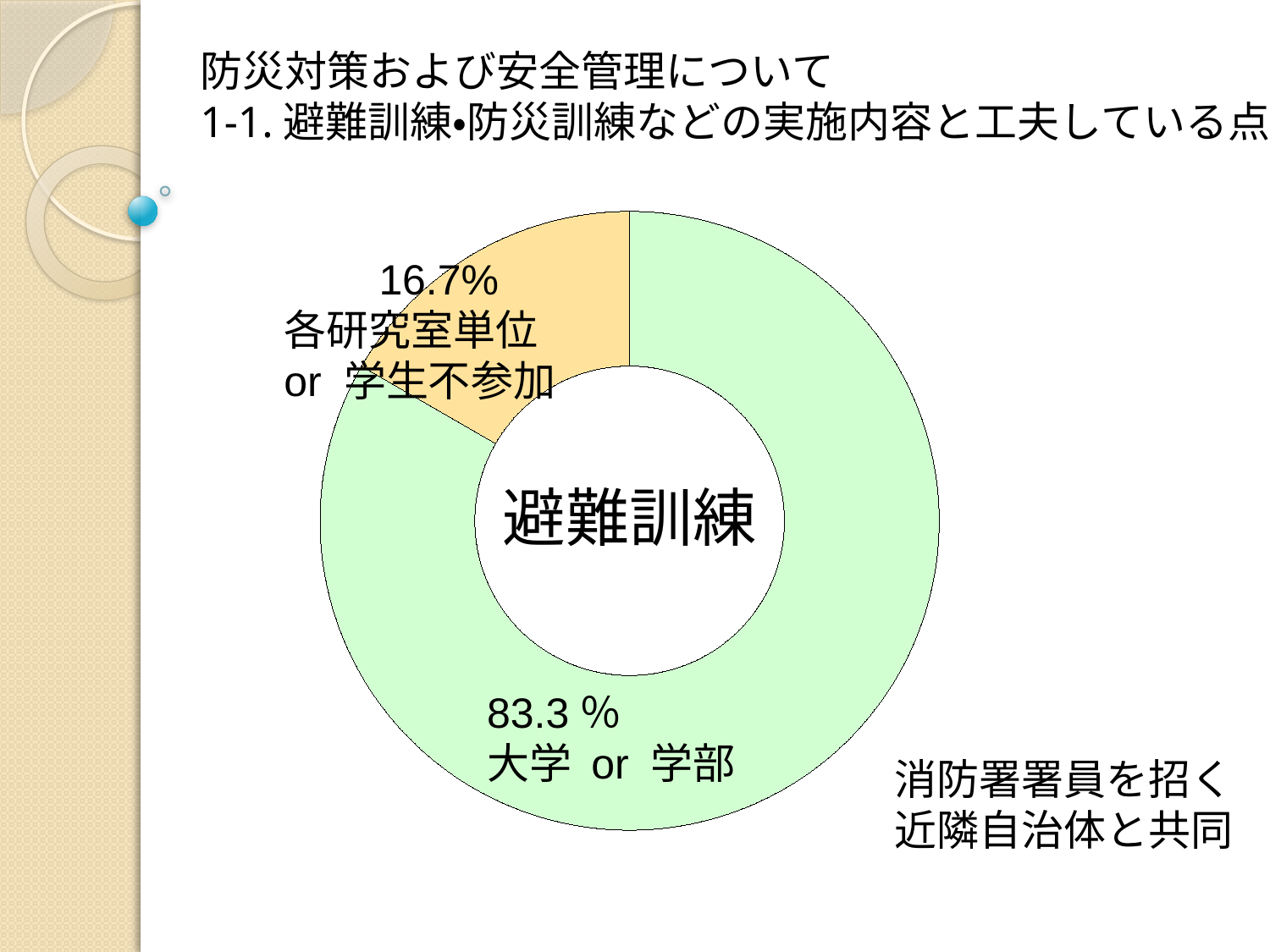
What colour is the slice for 大学 or 学部? green What share of the chart is labelled 各研究室単位 or 学生不参加? 16.7% How many slices does the chart have? 2 Which slice of the chart is the largest? 大学 or 学部 What is the difference in percentage points between the 大学 or 学部 slice and the 各研究室単位 or 学生不参加 slice? 66.6 Which slice of the chart is the smallest? 各研究室単位 or 学生不参加 What kind of chart is shown on the slide? doughnut chart Which is larger, the slice for 大学 or 学部 or the slice for 各研究室単位 or 学生不参加? 大学 or 学部 What share of the chart is labelled 大学 or 学部? 83.3 % What text is written in the centre of the doughnut chart? 避難訓練